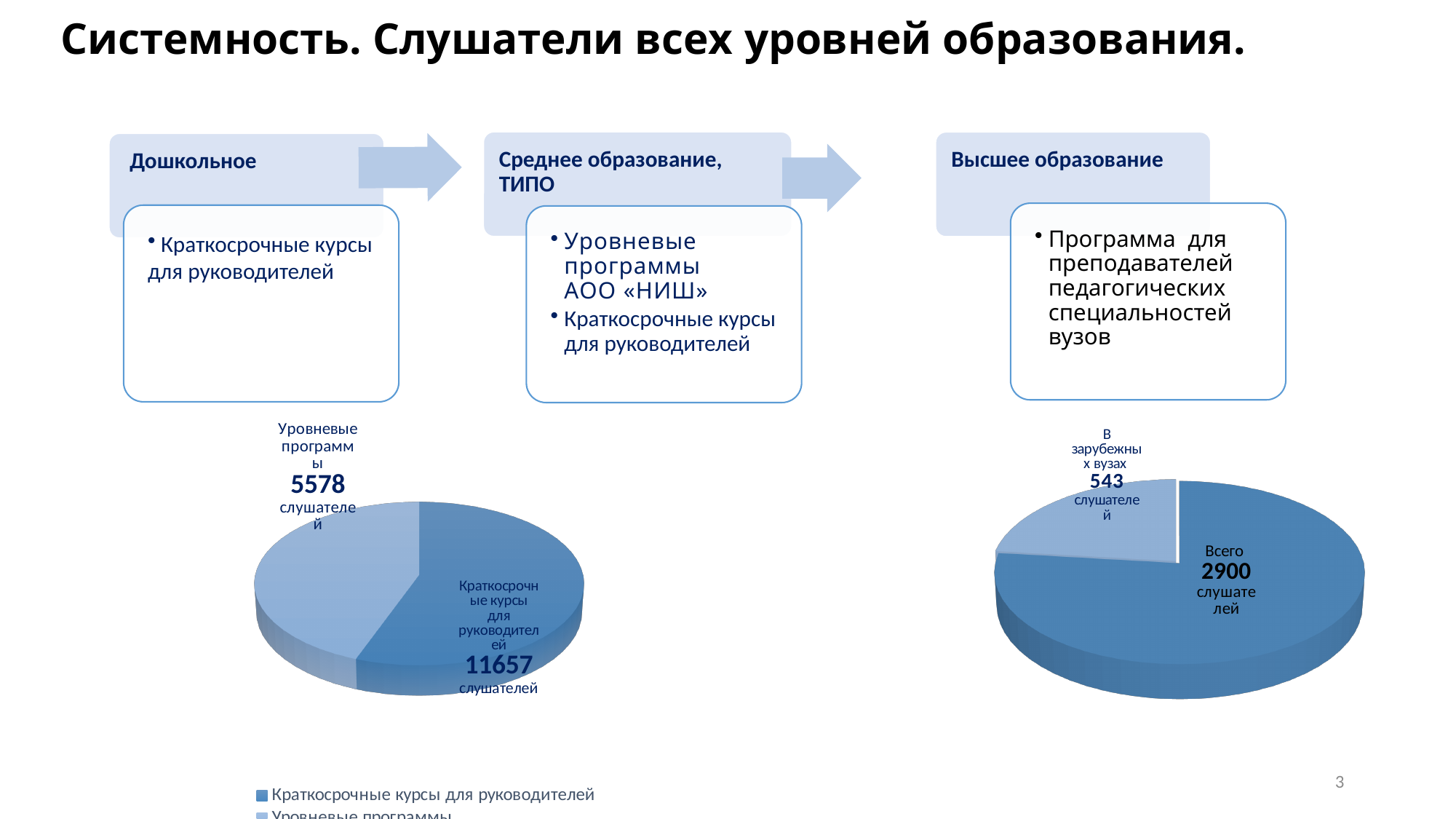
In the left pie chart, how many listeners are shown for Краткосрочные курсы для руководителей? 11657 In the left pie chart, which category has the smaller number of listeners? Уровневые программы In the right pie chart, what is the difference between the Всего value and the В зарубежных вузах value? 2357 How many slices does the right pie chart have? 2 How many entries does the legend of the left pie chart list? 2 In the left pie chart, which category has the larger number of listeners? Краткосрочные курсы для руководителей In the right pie chart, how many listeners are shown for В зарубежных вузах? 543 What type of chart is the left chart on the slide? Pie chart In the left pie chart, what is the difference between the listeners of Краткосрочные курсы для руководителей and Уровневые программы? 6079 In the right pie chart, which is larger: the Всего value or the В зарубежных вузах value? Всего In the left pie chart, how many listeners are shown for Уровневые программы? 5578 In the right pie chart, what is the value labelled Всего? 2900